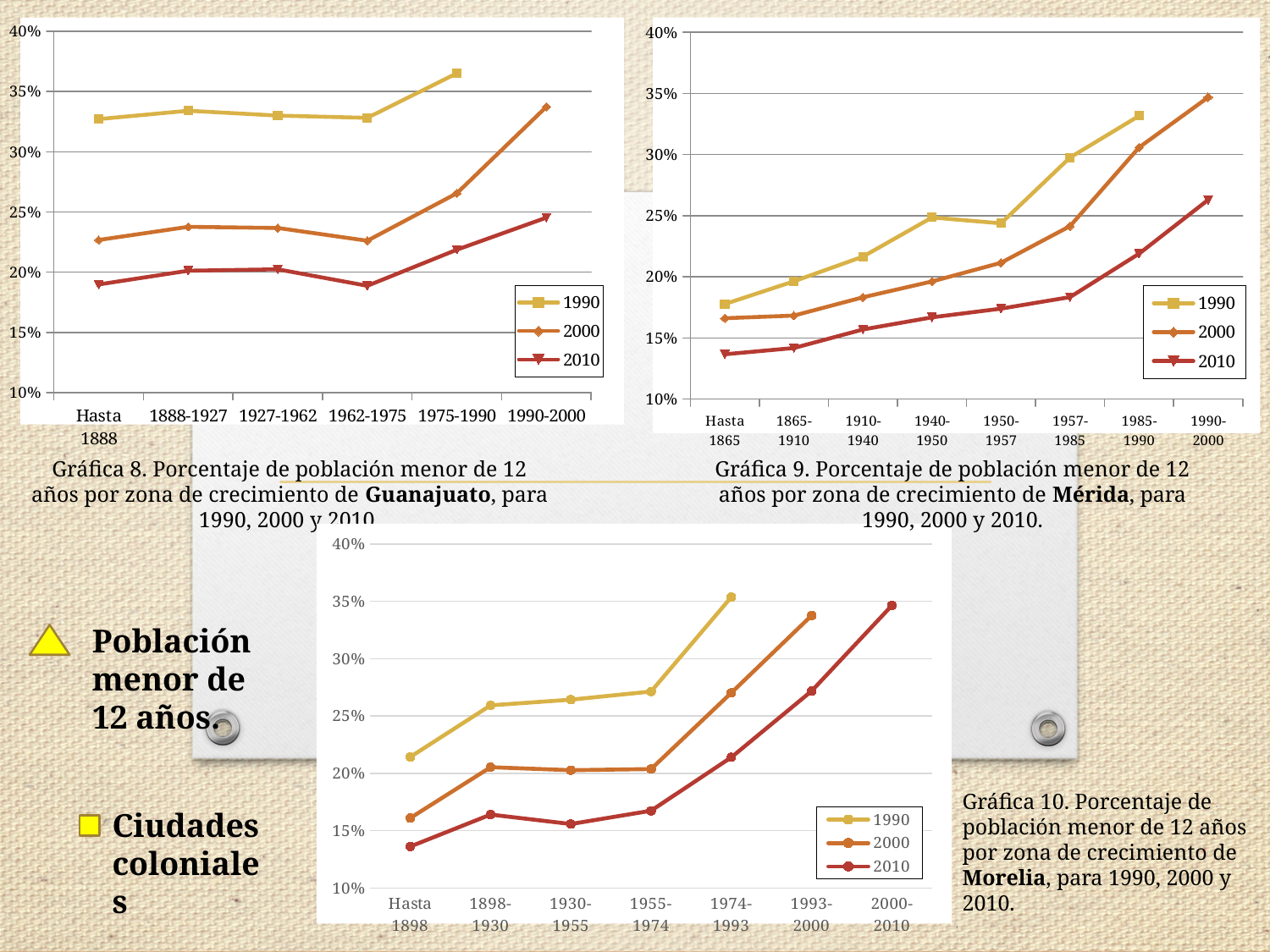
In Gráfica 8 (Guanajuato), which category has the highest value for the 2010 series? 1990-2000 What kind of chart is Gráfica 8 (Guanajuato)? line chart In Gráfica 10 (Morelia), is the 1990 value for 'Hasta 1898' greater or less than 20%? greater In Gráfica 9 (Mérida), is the 2010 value for 'Hasta 1865' greater or less than 15%? less In Gráfica 8 (Guanajuato), is the 1990 value for '1975-1990' greater or less than 35%? greater How many growth-zone categories are shown on the x axis of Gráfica 9 (Mérida)? 8 How many series does the legend of Gráfica 9 (Mérida) list? 3 How many growth-zone categories are shown on the x axis of Gráfica 8 (Guanajuato)? 6 In Gráfica 9 (Mérida), does the 2010 series rise or fall along the x axis? rise How many growth-zone categories are shown on the x axis of Gráfica 10 (Morelia)? 7 In Gráfica 10 (Morelia), which series has the highest value for 'Hasta 1898'? 1990